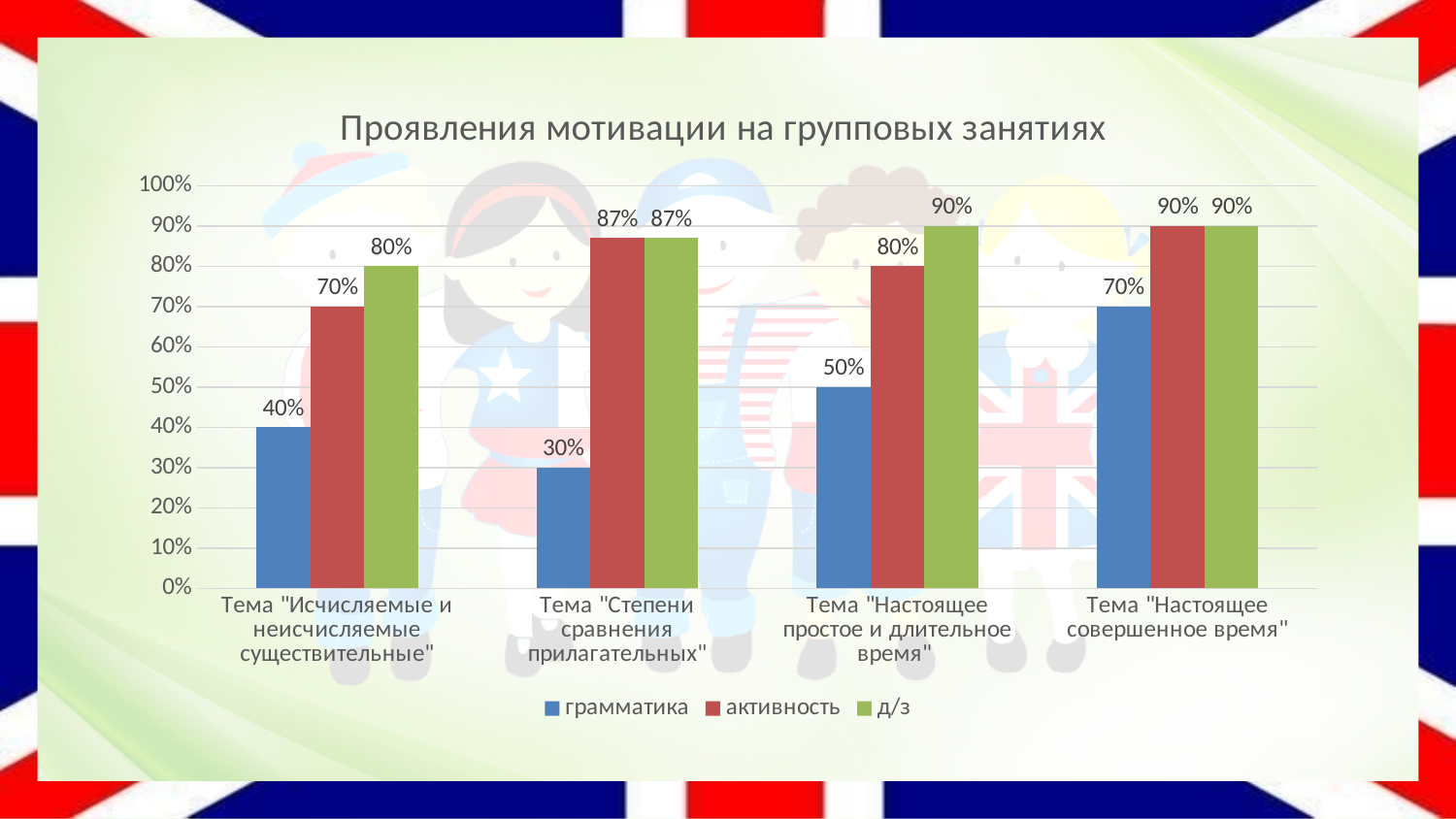
What is the value of грамматика for Тема "Настоящее совершенное время"? 70% For Тема "Настоящее простое и длительное время", which is larger: активность or д/з? д/з What is the value of д/з for Тема "Настоящее простое и длительное время"? 90% Which category has the lowest грамматика value? Тема "Степени сравнения прилагательных" What is the title of the chart? Проявления мотивации на групповых занятиях What is the difference between the д/з and грамматика values for Тема "Степени сравнения прилагательных"? 57% Which category has the highest грамматика value? Тема "Настоящее совершенное время" What is the value of активность for Тема "Степени сравнения прилагательных"? 87% How many series does the legend list? 3 What is the value of грамматика for Тема "Исчисляемые и неисчисляемые существительные"? 40% How many categories are shown on the x axis? 4 What kind of chart is shown on the slide? Bar chart